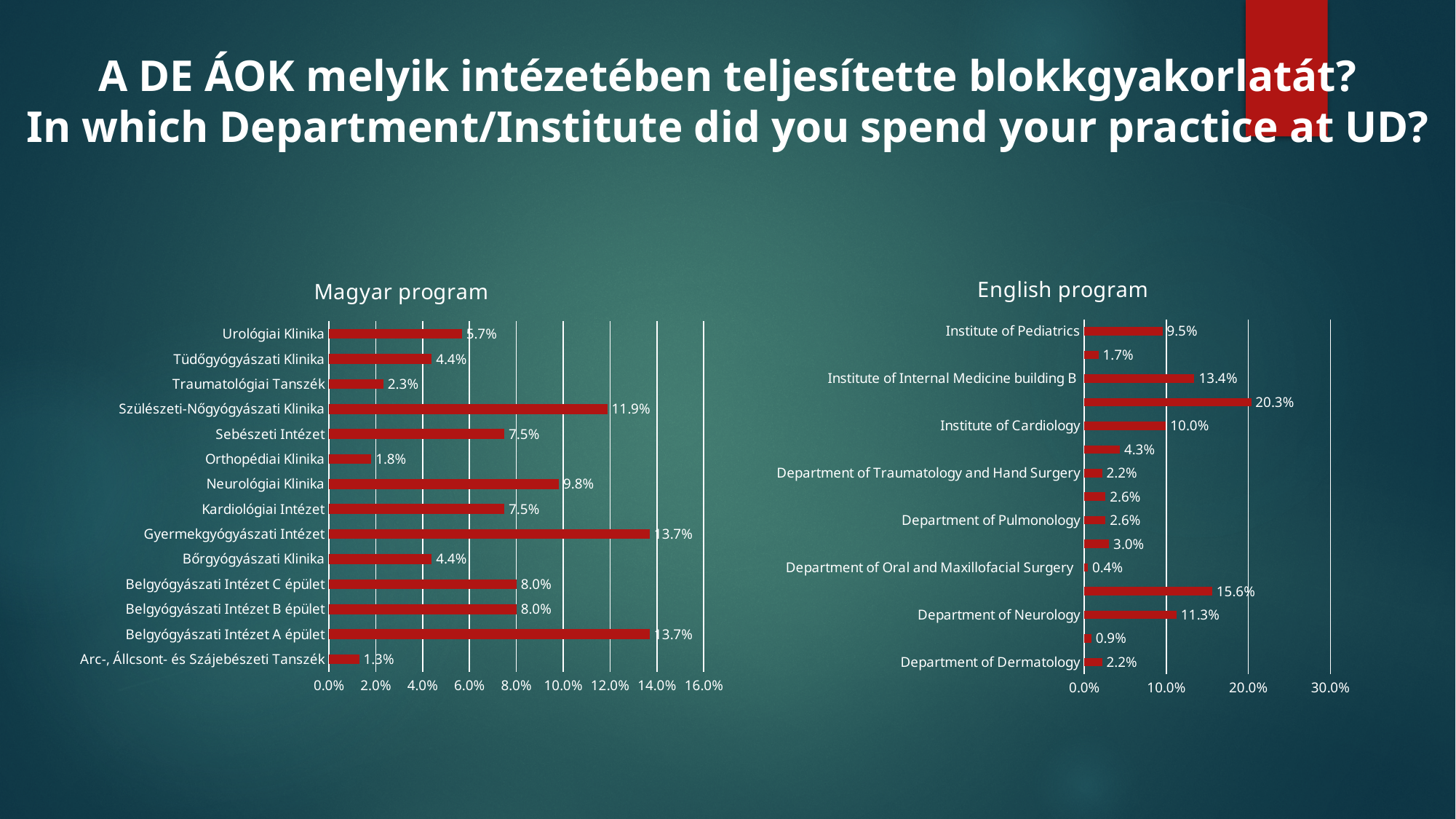
In the English program chart, is the value for Institute of Cardiology greater or less than 20.0%? less In the English program chart, which labelled category has the lowest value? Department of Oral and Maxillofacial Surgery In the Magyar program chart, which category has the lowest value? Arc-, Állcsont- és Szájebészeti Tanszék In the Magyar program chart, what is the value for Neurológiai Klinika? 9.8% In the Magyar program chart, which is larger, Urológiai Klinika or Tüdőgyógyászati Klinika? Urológiai Klinika In the Magyar program chart, how many categories are plotted? 14 In the Magyar program chart, what is the difference between Gyermekgyógyászati Intézet and Sebészeti Intézet? 6.2% In the English program chart, what is the value for Department of Neurology? 11.3% In the English program chart, what is the value for Institute of Internal Medicine building B? 13.4% In the Magyar program chart, what is the value for Szülészeti-Nőgyógyászati Klinika? 11.9% What kind of chart is the English program chart? bar chart What is the title of the chart on the left side of the slide? Magyar program